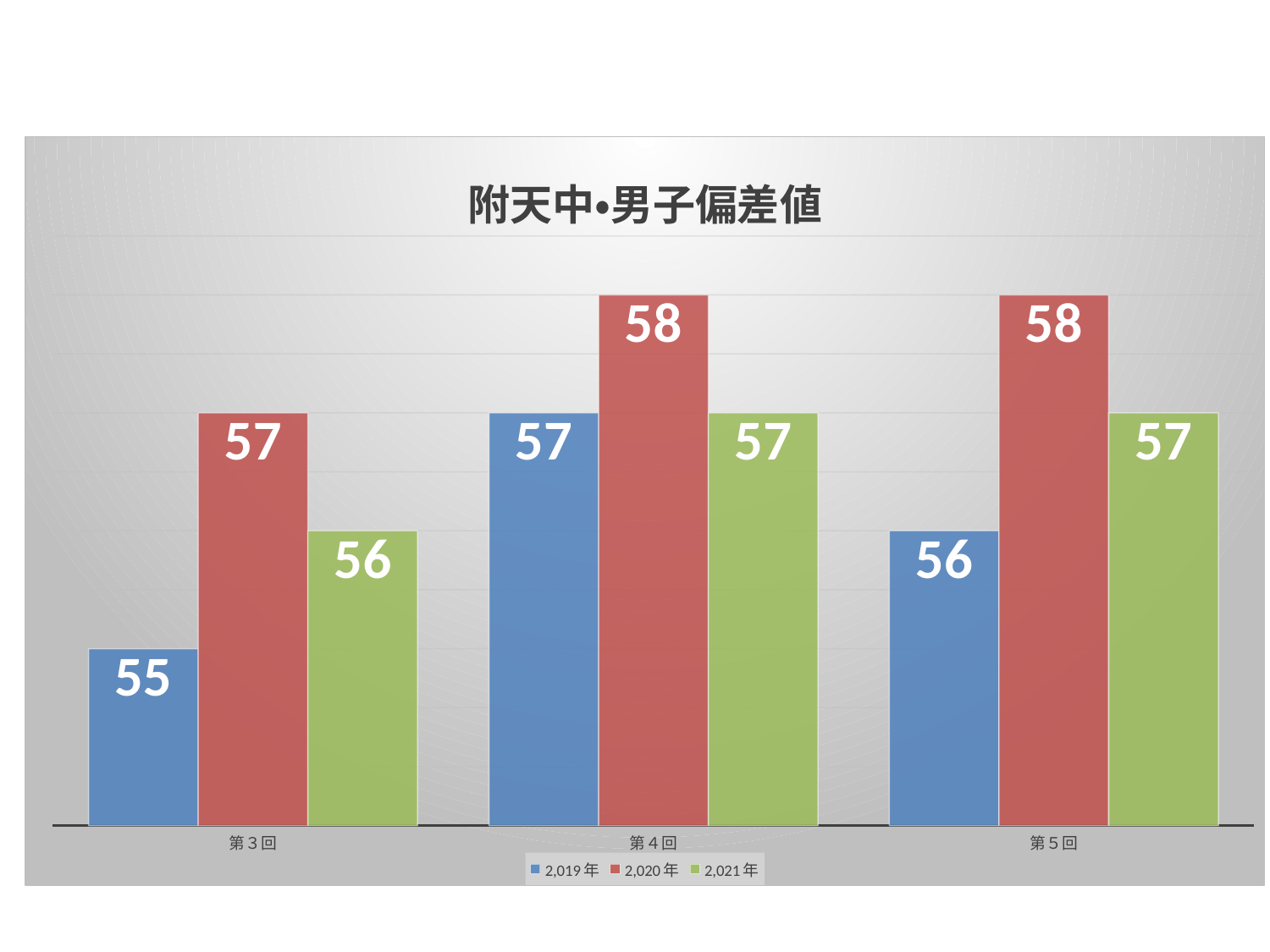
What is the title of the chart? 附天中•男子偏差値 What is the difference between the 2,020年 and 2,019年 values at 第3回? 2 Which series has the highest value at 第3回? 2,020年 What is the value for 2,019年 at 第5回? 56 Which series has the lowest value at 第5回? 2,019年 What is the value for 2,019年 at 第3回? 55 What kind of chart is this? bar chart How many categories are shown on the x axis? 3 What is the value for 2,021年 at 第5回? 57 How many series does the legend list? 3 What is the value for 2,020年 at 第4回? 58 Which is larger at 第4回: the value for 2,019年 or the value for 2,020年? 2,020年